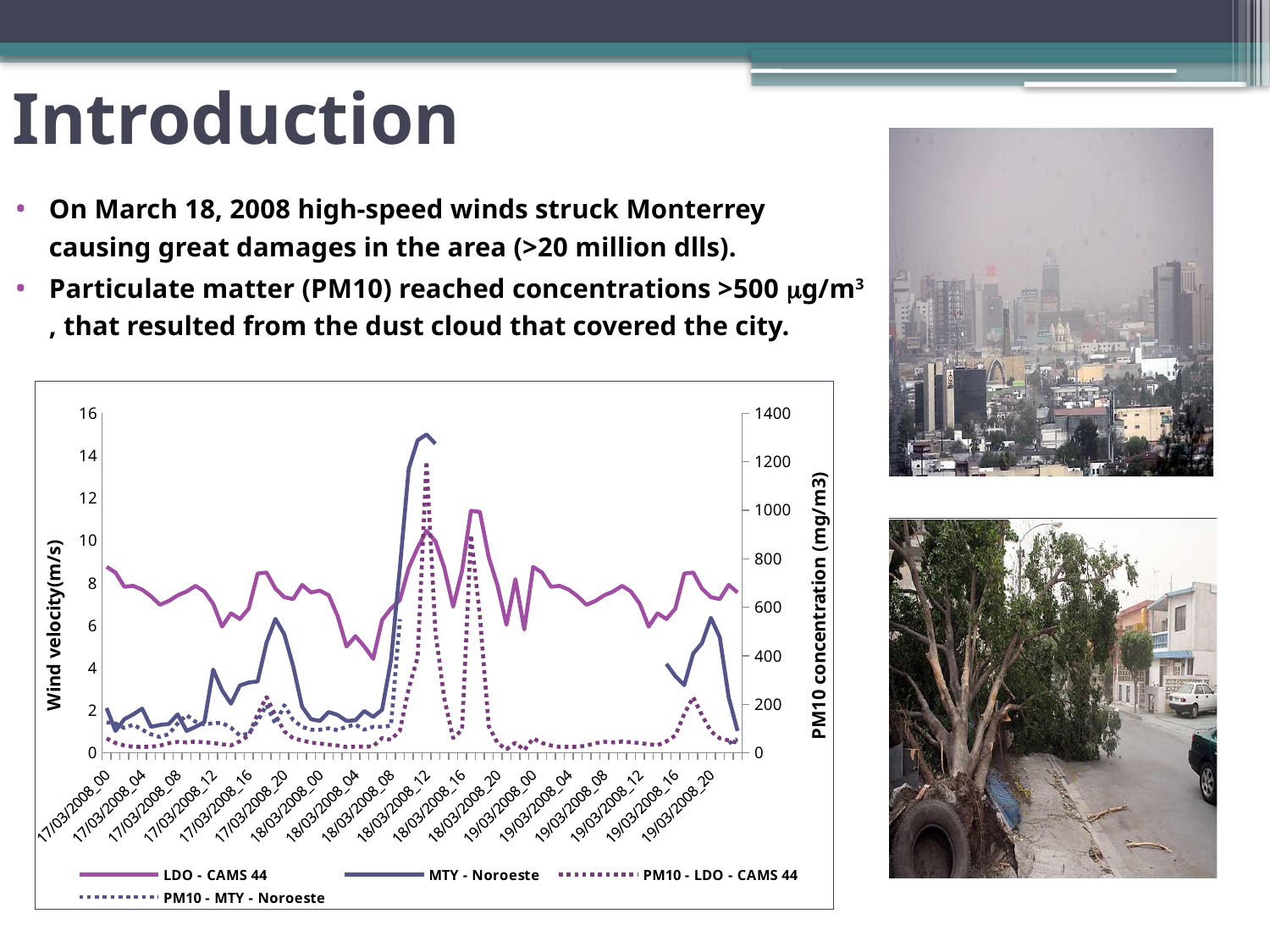
Is the value of MTY - Noroeste at 17/03/2008_00 greater or less than 4 m/s? less Which wind velocity series reaches the highest value on the chart? MTY - Noroeste What kind of chart is shown on the slide? line chart Is the peak value of the MTY - Noroeste series greater or less than 14 m/s? greater How many series does the chart's legend list? 4 Around 18/03/2008_12, which PM10 series reaches the higher peak, PM10 - LDO - CAMS 44 or PM10 - MTY - Noroeste? PM10 - LDO - CAMS 44 Is the peak value of the PM10 - LDO - CAMS 44 series greater or less than 1000 mg/m3? greater What is the title of the right vertical axis of the chart? PM10 concentration (mg/m3) What is the title of the left vertical axis of the chart? Wind velocity(m/s) How many tick labels are shown on the x axis of the chart? 18